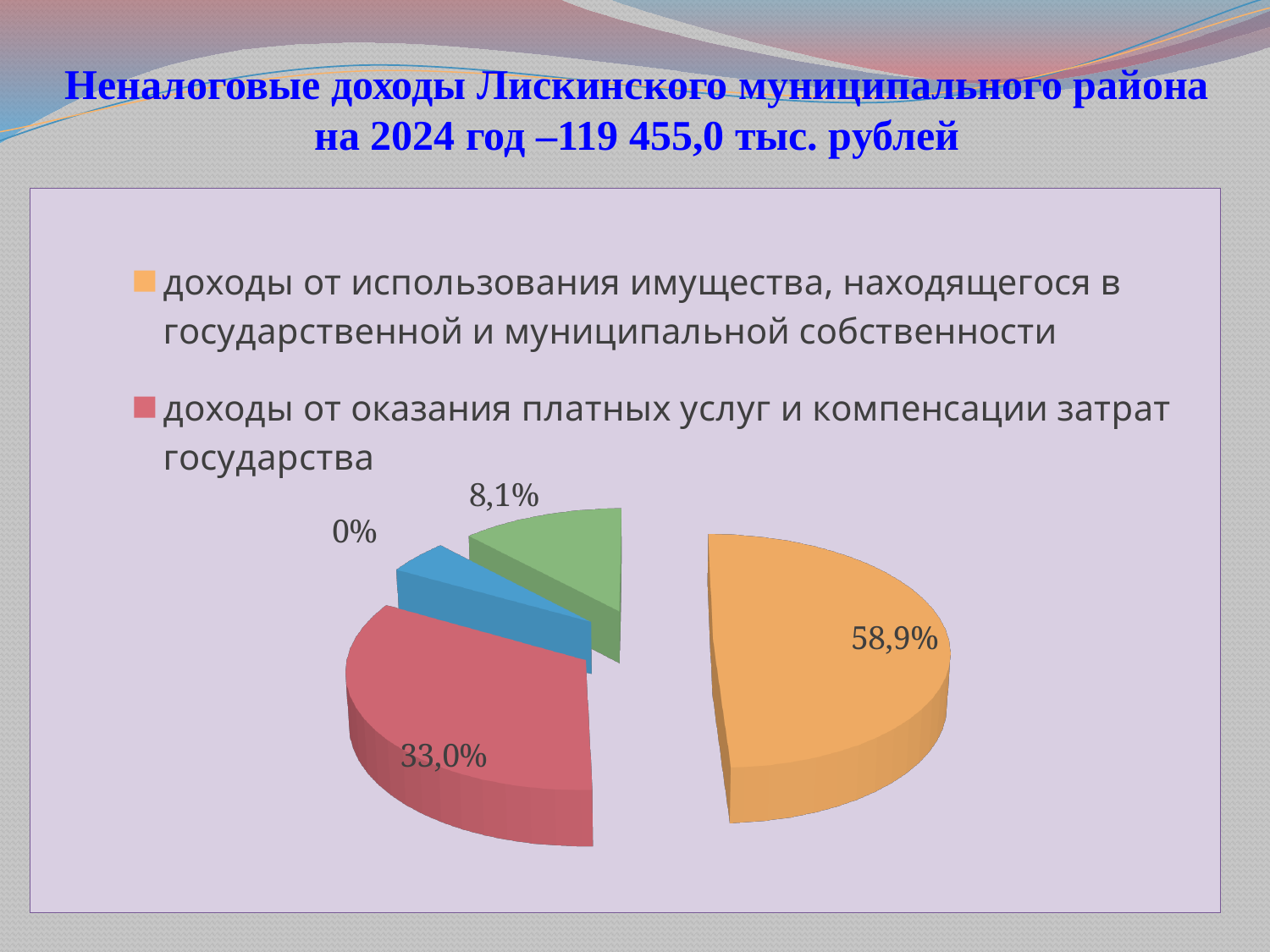
What type of chart is shown on the slide? pie chart What is the smallest percentage label shown on the pie chart? 0% How many slices does the pie chart have? 4 What is the largest percentage label shown on the pie chart? 58,9% What share of the pie is labelled for 'доходы от использования имущества, находящегося в государственной и муниципальной собственности'? 58,9% Which legend category has the largest slice of the pie? доходы от использования имущества, находящегося в государственной и муниципальной собственности Which is larger: the slice for 'доходы от оказания платных услуг и компенсации затрат государства' or the slice for 'доходы от использования имущества, находящегося в государственной и муниципальной собственности'? доходы от использования имущества, находящегося в государственной и муниципальной собственности By how many percentage points does the slice for 'доходы от использования имущества' exceed the slice for 'доходы от оказания платных услуг и компенсации затрат государства'? 25,9% What share of the pie is labelled for 'доходы от оказания платных услуг и компенсации затрат государства'? 33,0% What total amount of non-tax revenue for 2024 is stated in the slide title? 119 455,0 тыс. рублей What colour is the slice labelled 33,0%? red How many entries does the legend list? 2